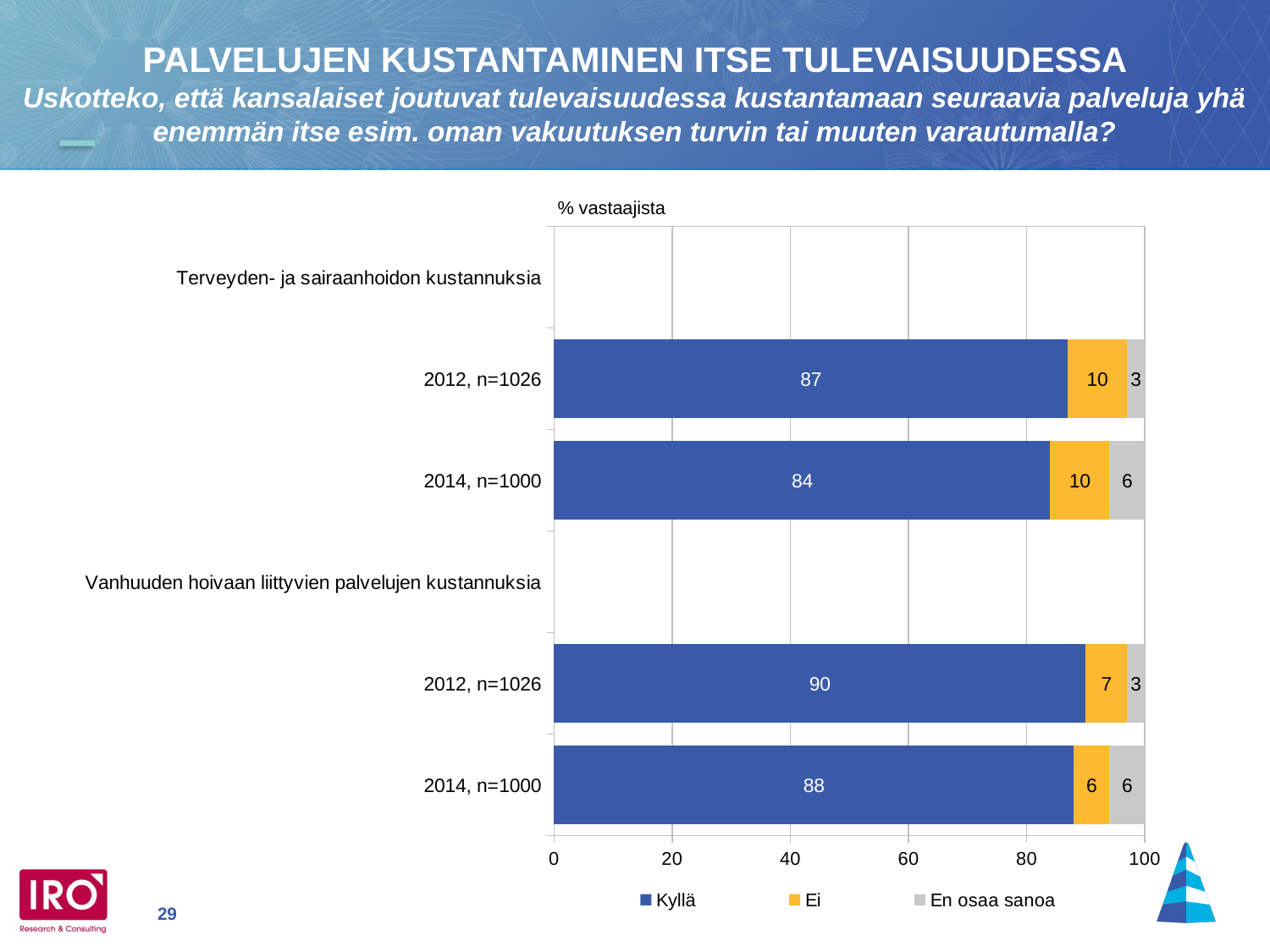
What is the Kyllä value for 2012, n=1026 under Terveyden- ja sairaanhoidon kustannuksia? 87 What is the total of the stacked bar for 2014, n=1000 under Terveyden- ja sairaanhoidon kustannuksia? 100 Which bar has the highest Kyllä value? 2012, n=1026 under Vanhuuden hoivaan liittyvien palvelujen kustannuksia What is the Kyllä value for 2014, n=1000 under Vanhuuden hoivaan liittyvien palvelujen kustannuksia? 88 What is the Ei value for 2012, n=1026 under Vanhuuden hoivaan liittyvien palvelujen kustannuksia? 7 How many series does the legend list? 3 Under Vanhuuden hoivaan liittyvien palvelujen kustannuksia, is the Kyllä value larger in 2012 or 2014? 2012 Which bar has the lowest Kyllä value? 2014, n=1000 under Terveyden- ja sairaanhoidon kustannuksia What is the En osaa sanoa value for 2014, n=1000 under Terveyden- ja sairaanhoidon kustannuksia? 6 What is the difference between the Kyllä values for 2012 and 2014 under Terveyden- ja sairaanhoidon kustannuksia? 3 What kind of chart is shown on the slide? Stacked bar chart What is the axis label shown above the chart? % vastaajista